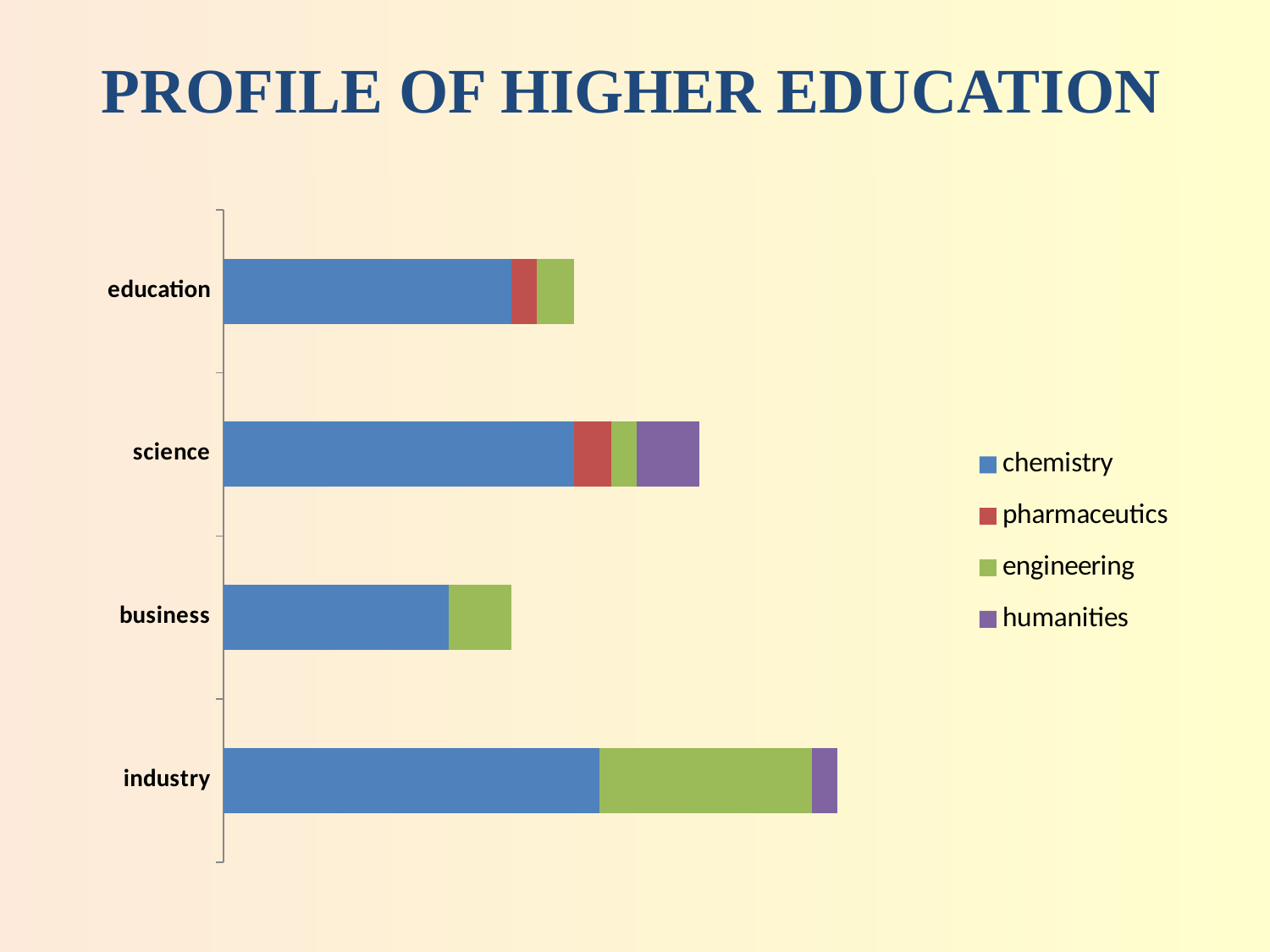
Which series is shown in blue in the legend? chemistry Which category has the larger chemistry segment, industry or business? industry Which category has the largest engineering segment? industry What kind of chart is shown on the slide? Stacked bar chart How many series does the legend list? 4 Which category has the shortest total bar? business How many categories are plotted on the chart? 4 Which category has the largest humanities segment? science Which category has the longest total bar? industry Which category is listed at the top of the chart? education Which category has the larger total bar, science or education? science Which categories include a humanities segment? science and industry